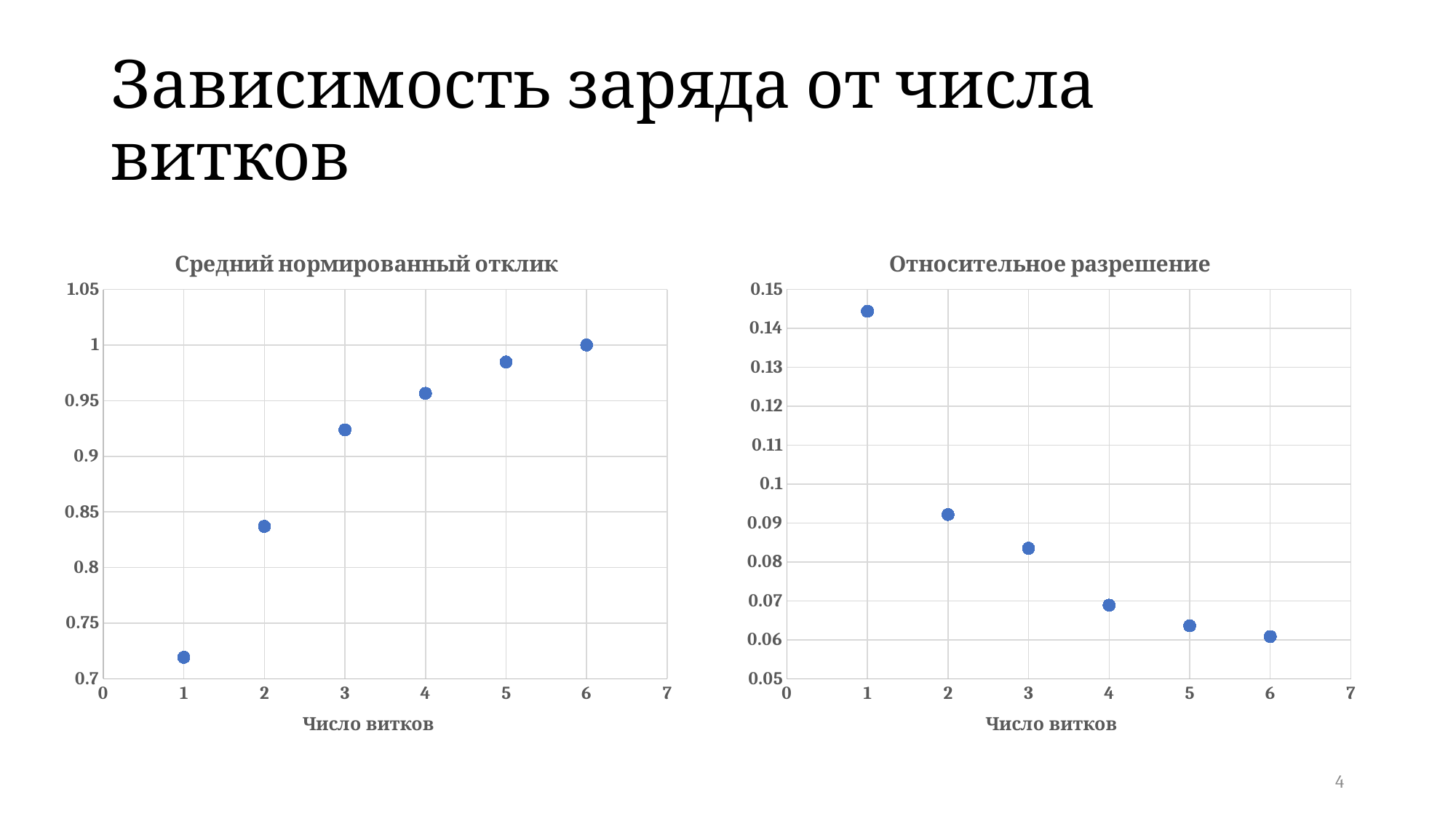
In the chart titled "Относительное разрешение", at which number of turns (Число витков) is the value highest? 1 In the chart titled "Средний нормированный отклик", at which number of turns (Число витков) is the value highest? 6 In the chart titled "Относительное разрешение", which is larger: the value at 2 turns or the value at 4 turns? 2 turns What kind of chart is the chart titled "Средний нормированный отклик"? scatter chart How many data points are plotted in the chart titled "Относительное разрешение"? 6 In the chart titled "Относительное разрешение", at which number of turns (Число витков) is the value lowest? 6 In the chart titled "Относительное разрешение", is the value at 1 turn greater or less than 0.14? greater In the chart titled "Средний нормированный отклик", is the value at 2 turns greater or less than 0.85? less What is the x-axis label of the chart titled "Средний нормированный отклик"? Число витков In the chart titled "Средний нормированный отклик", at which number of turns (Число витков) is the value lowest? 1 In the chart titled "Относительное разрешение", do the values rise or fall as the number of turns increases? fall In the chart titled "Средний нормированный отклик", do the values rise or fall as the number of turns increases? rise